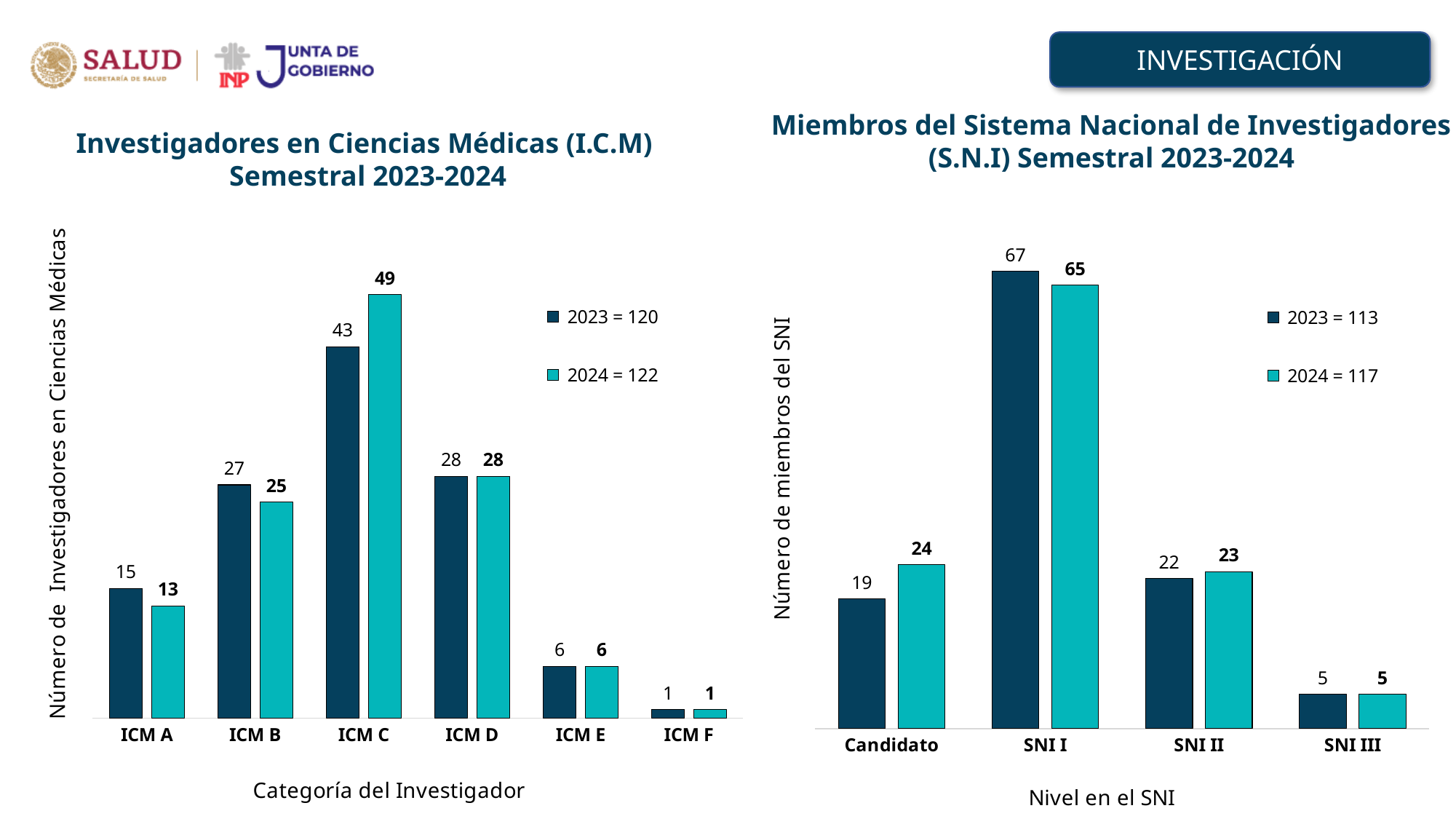
In the 'Miembros del Sistema Nacional de Investigadores (S.N.I) Semestral 2023-2024' chart, what is the 2023 value for SNI I? 67 In the 'Miembros del Sistema Nacional de Investigadores (S.N.I) Semestral 2023-2024' chart, how many series does the legend list? 2 What type of chart is the 'Miembros del Sistema Nacional de Investigadores (S.N.I) Semestral 2023-2024' chart? Bar chart In the 'Investigadores en Ciencias Médicas (I.C.M) Semestral 2023-2024' chart, how many categories are shown on the x axis? 6 In the 'Investigadores en Ciencias Médicas (I.C.M) Semestral 2023-2024' chart, what is the 2023 value for ICM B? 27 In the 'Investigadores en Ciencias Médicas (I.C.M) Semestral 2023-2024' chart, which category has the lowest 2024 value? ICM F In the 'Investigadores en Ciencias Médicas (I.C.M) Semestral 2023-2024' chart, which category has the highest 2023 value? ICM C In the 'Miembros del Sistema Nacional de Investigadores (S.N.I) Semestral 2023-2024' chart, what is the 2024 value for Candidato? 24 In the 'Miembros del Sistema Nacional de Investigadores (S.N.I) Semestral 2023-2024' chart, which is larger for SNI II: the 2023 value or the 2024 value? 2024 In the 'Investigadores en Ciencias Médicas (I.C.M) Semestral 2023-2024' chart, what is the difference between the 2024 and 2023 values for ICM C? 6 In the 'Miembros del Sistema Nacional de Investigadores (S.N.I) Semestral 2023-2024' chart, what is the difference between the 2023 and 2024 values for SNI I? 2 In the 'Investigadores en Ciencias Médicas (I.C.M) Semestral 2023-2024' chart, what is the 2024 value for ICM C? 49